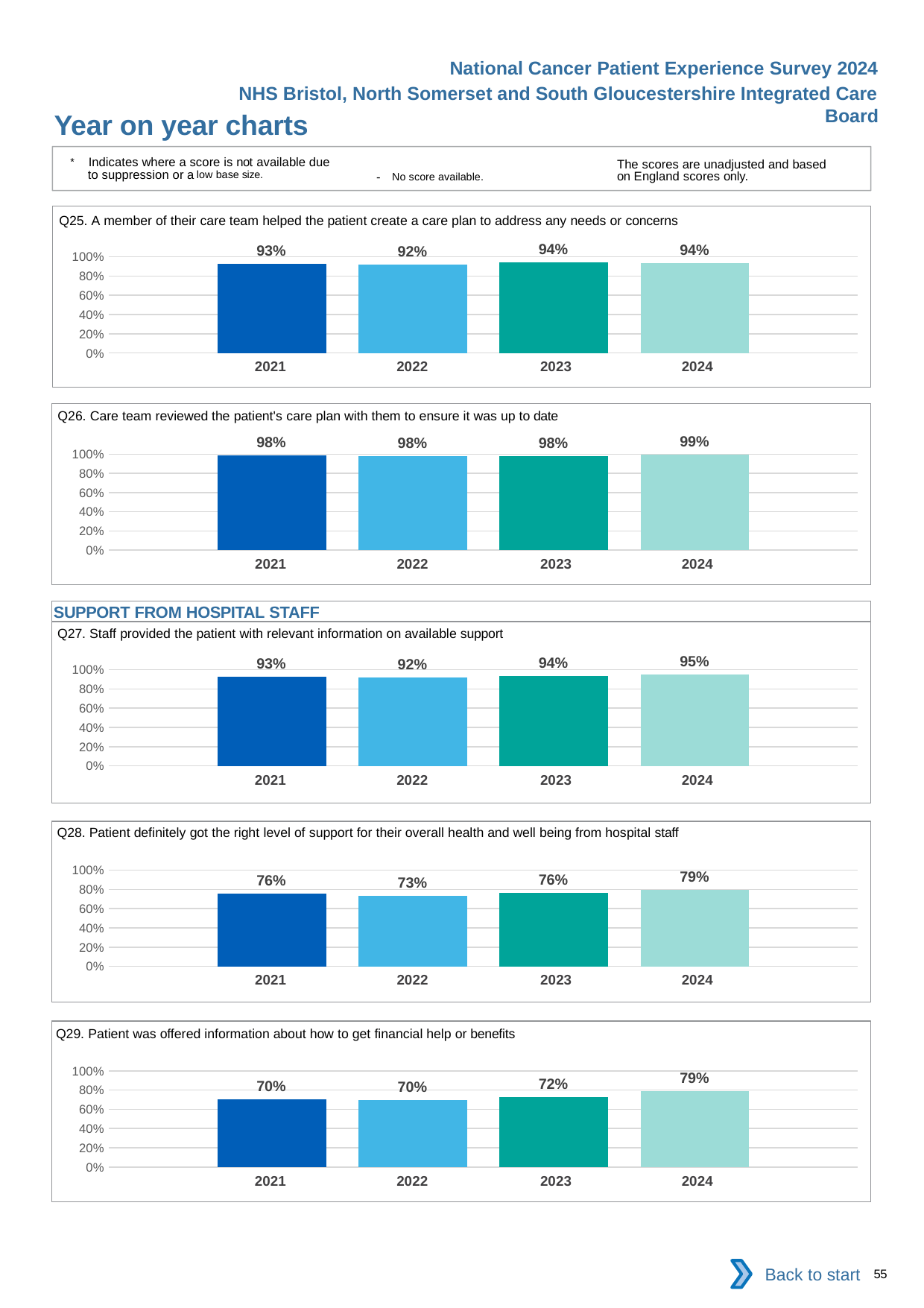
In the Q28 chart (right level of support from hospital staff), is the value for 2022 greater or less than 80%? less In the Q29 chart (information about financial help or benefits), do the values rise or fall from 2021 to 2024? Rise In the Q26 chart (care team reviewed the care plan), which year has the highest value? 2024 In the Q28 chart (right level of support from hospital staff), what is the difference between the 2024 and 2022 values? 6% What kind of chart is the Q26 chart (care team reviewed the care plan)? Bar chart In the Q29 chart (information about financial help or benefits), what is the value for 2023? 72% How many years are shown on the x axis of the Q25 chart? 4 In the Q27 chart (staff provided relevant information on available support), what is the value for 2024? 95% In the Q29 chart (information about financial help or benefits), what is the difference between the 2024 and 2021 values? 9% In the Q28 chart (right level of support from hospital staff), which year has the lowest value? 2022 In the Q29 chart (information about financial help or benefits), is the value for 2024 larger than the value for 2023? Yes In the Q25 chart (care team helped create a care plan), what is the value for 2022? 92%